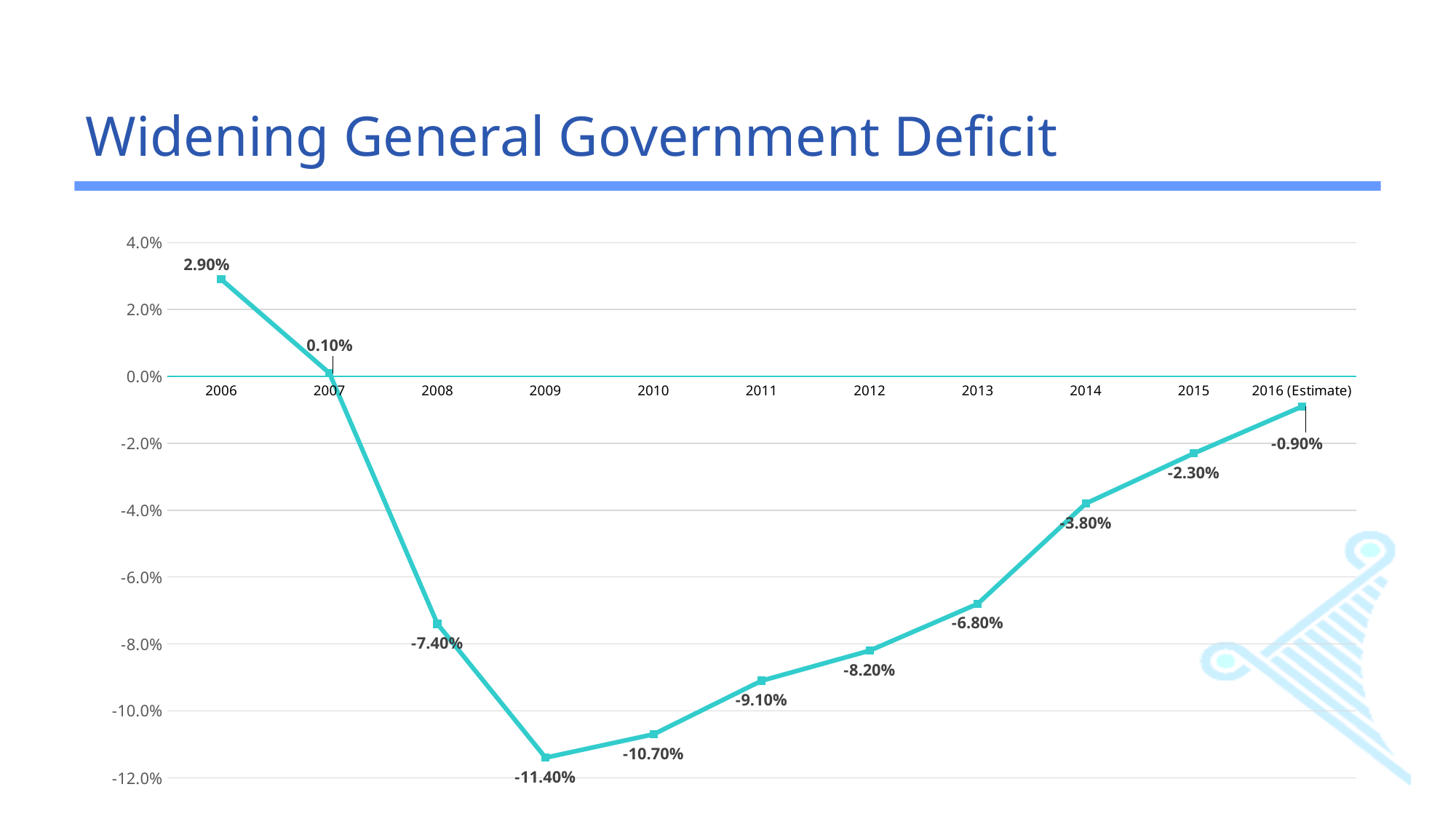
Which is larger, the value for 2014 or the value for 2015? 2015 What is the difference between the values for 2008 and 2009? 4.00% What is the value for 2009? -11.40% Do the values rise or fall from 2009 to 2016 (Estimate)? Rise Which year has the lowest value? 2009 What is the value for 2016 (Estimate)? -0.90% What is the value for 2012? -8.20% Which year has the highest value? 2006 How many data points are plotted on the chart? 11 What is the title of the chart? Widening General Government Deficit What kind of chart is shown on the slide? Line chart What is the value for 2006? 2.90%